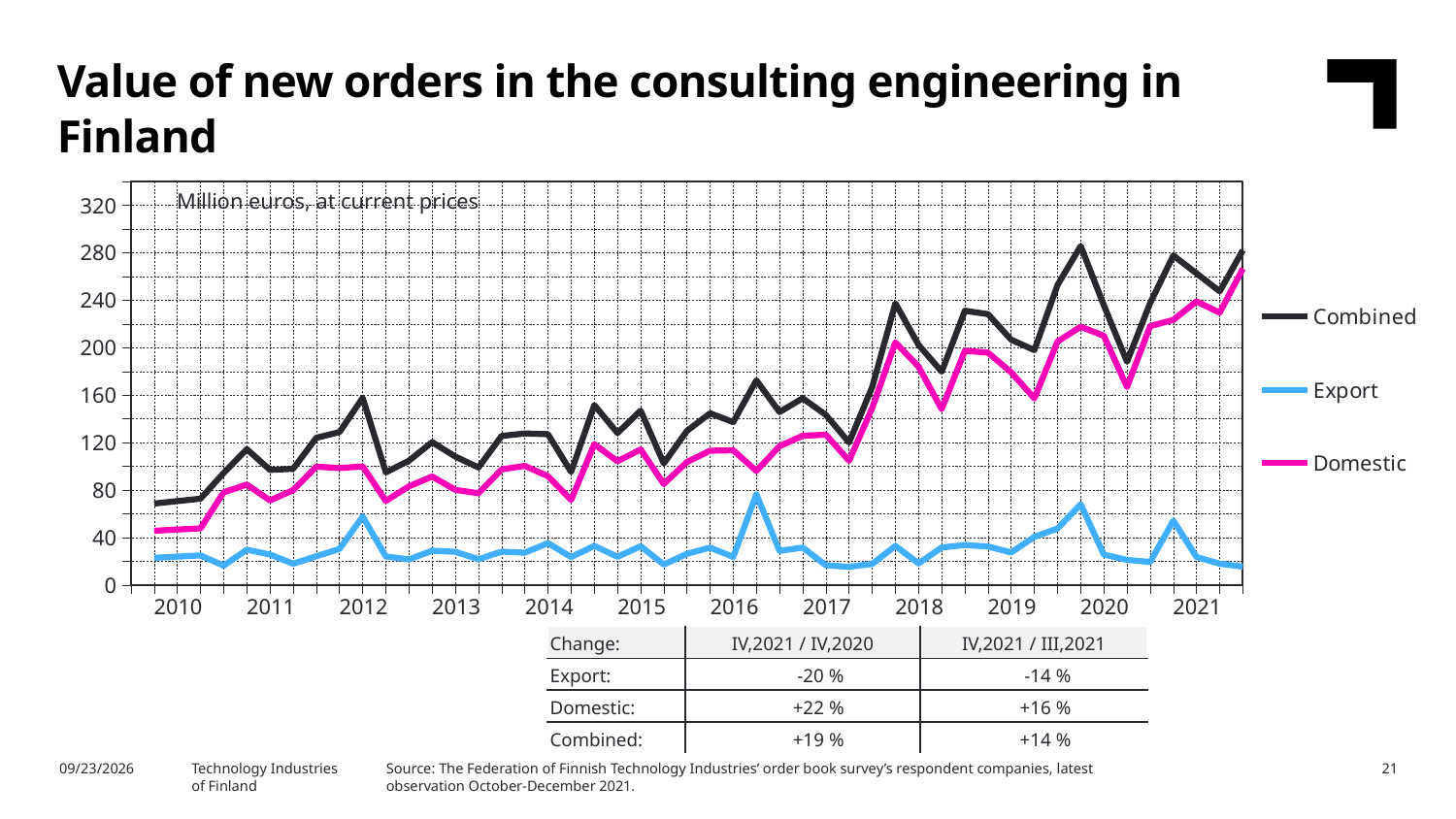
Is the value for Combined at the start of 2010 greater or less than 80? less Does the Combined series rise or fall overall from 2010 to 2021? rise According to the table below the chart, what is the Export change for IV,2021 / IV,2020? -20 % How many series does the legend list? 3 Is the value for Domestic at the end of 2021 greater or less than 240? greater What kind of chart is shown on the slide? line chart Which series has the highest values throughout the chart? Combined How many years are labelled on the x axis? 12 Is the peak value for Export in 2012 greater or less than 40? greater Which series is larger in 2021, Domestic or Export? Domestic Which series has the lowest values throughout the chart? Export What unit is the chart measured in, according to the label inside the plot area? Million euros, at current prices